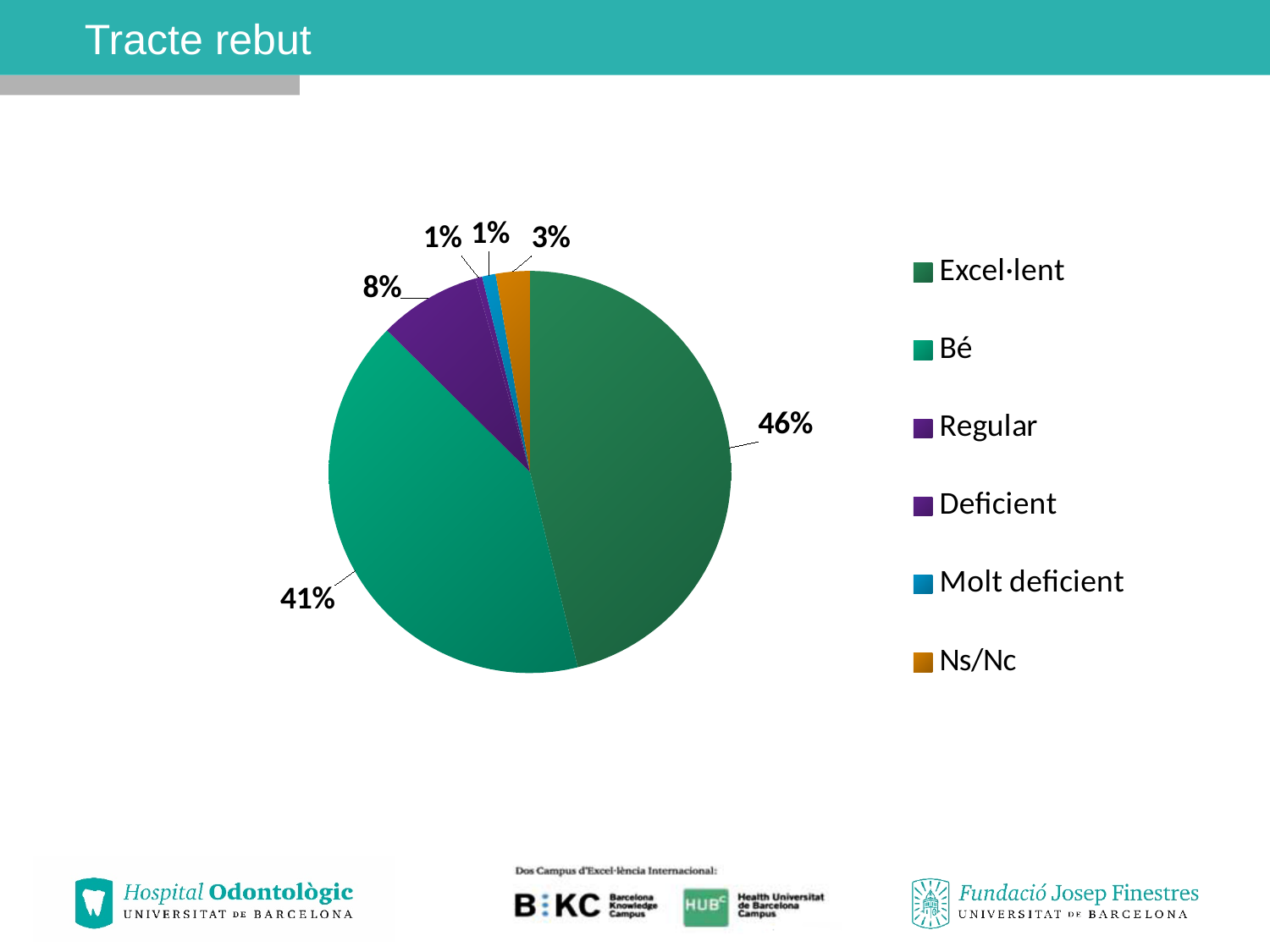
What percentage of the pie corresponds to Excel·lent? 46% Which is larger, the share for Regular or the share for Ns/Nc? Regular What is the title of the slide containing the chart? Tracte rebut What percentage of the pie corresponds to Ns/Nc? 3% Which category has the largest share of the pie? Excel·lent How many categories does the legend list? 6 What is the difference in percentage points between Excel·lent and Bé? 5% What percentage of the pie corresponds to Regular? 8% What percentage of the pie corresponds to Bé? 41% What is the combined share of Excel·lent and Bé? 87% What percentage of the pie corresponds to Molt deficient? 1% What type of chart is shown on the slide? pie chart